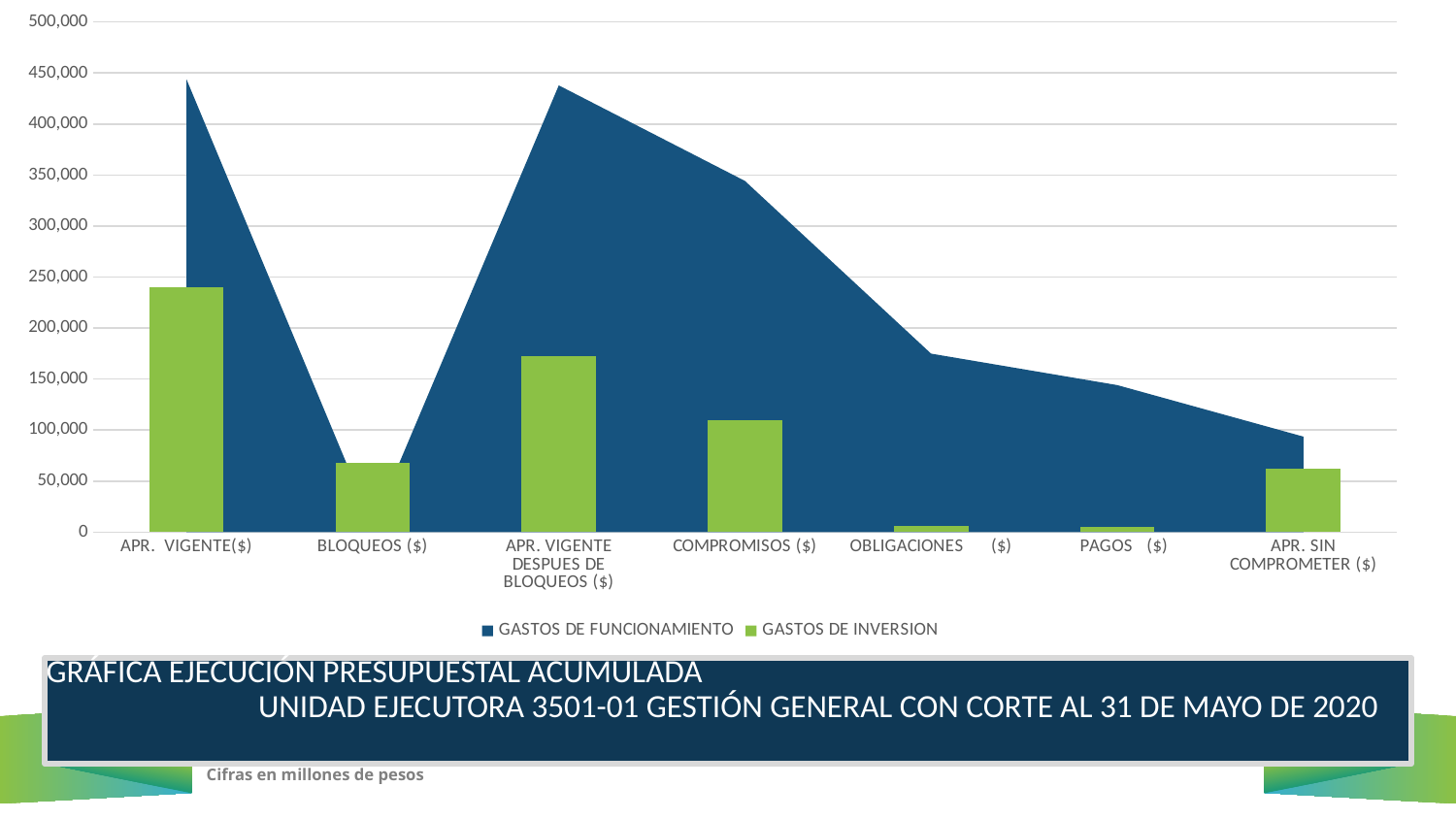
Which category has the lowest GASTOS DE FUNCIONAMIENTO value? BLOQUEOS ($) Is the GASTOS DE INVERSION value for APR. VIGENTE DESPUES DE BLOQUEOS ($) greater or less than 150,000? greater What kind of chart is this? A combined area and bar chart How many series does the legend list? 2 Is the GASTOS DE INVERSION value for OBLIGACIONES ($) greater or less than 50,000? less Which is larger for OBLIGACIONES ($): GASTOS DE FUNCIONAMIENTO or GASTOS DE INVERSION? GASTOS DE FUNCIONAMIENTO Which category has the highest GASTOS DE INVERSION value? APR. VIGENTE($) According to the note below the chart, in what units are the figures expressed? Millones de pesos How many categories are shown on the x axis? 7 Is the GASTOS DE INVERSION value for APR. VIGENTE($) greater or less than 250,000? less